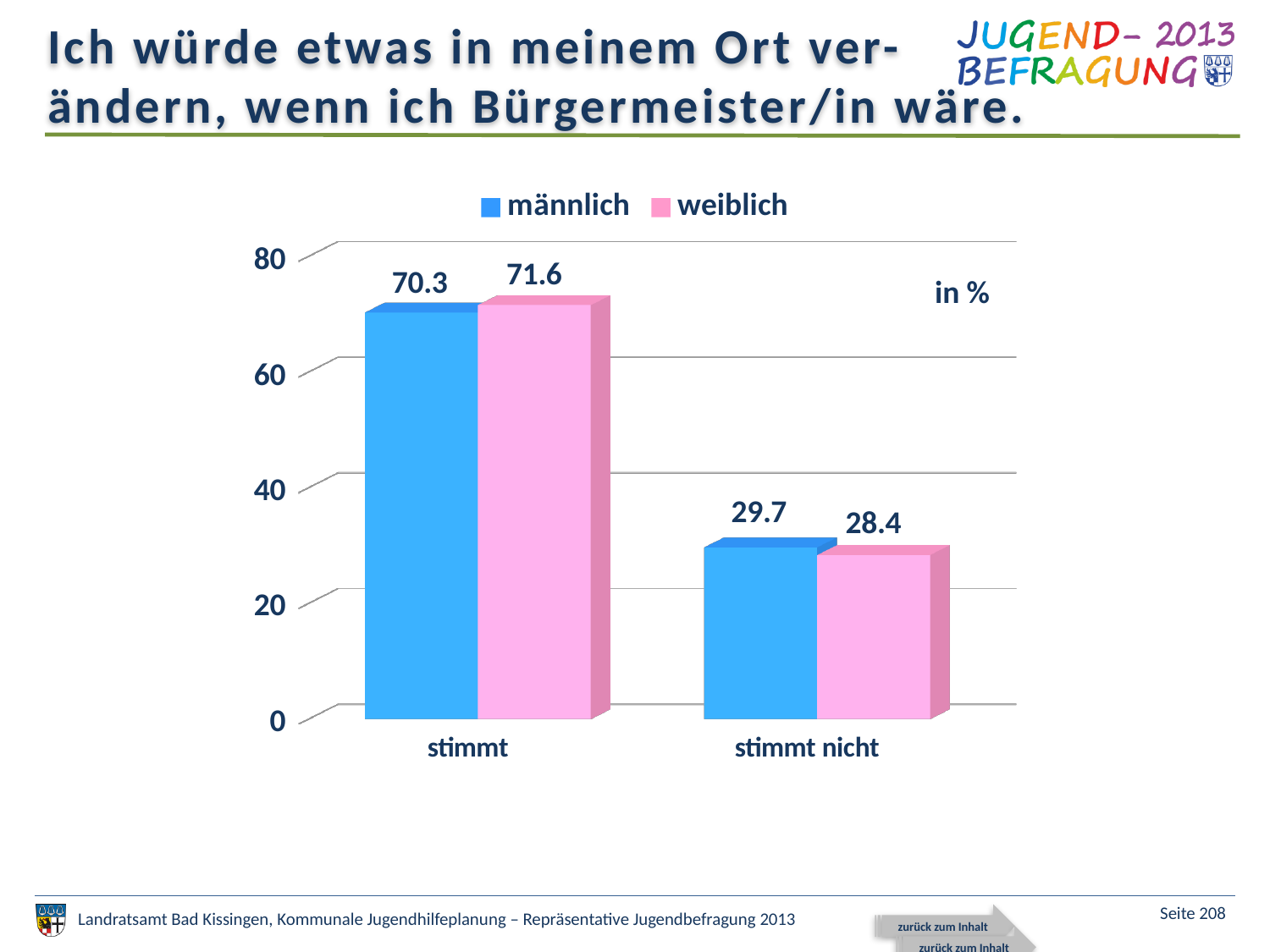
Which category has the lowest value for männlich? stimmt nicht Which category has the highest value for weiblich? stimmt What is the difference between the männlich and weiblich values in the stimmt nicht category? 1.3 What is the value for weiblich in the stimmt category? 71.6 How many series does the legend list? 2 How many categories are shown on the x axis? 2 What is the value for männlich in the stimmt category? 70.3 What kind of chart is shown on the slide? bar chart What is the value for weiblich in the stimmt nicht category? 28.4 What is the value for männlich in the stimmt nicht category? 29.7 What is the difference between the weiblich and männlich values in the stimmt category? 1.3 Is the männlich value for stimmt greater or less than 60? greater